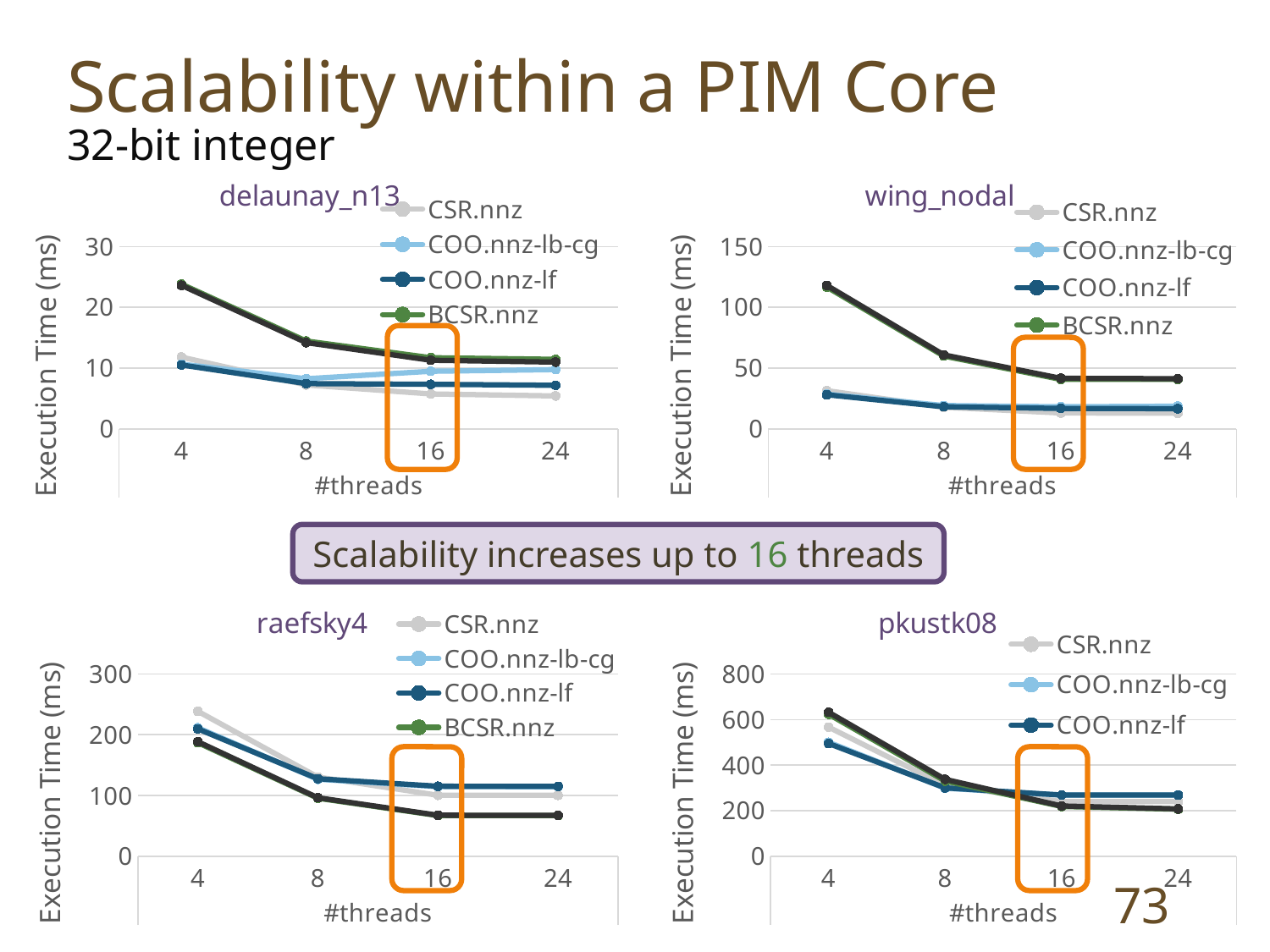
In the raefsky4 chart, is the value for CSR.nnz at 4 threads greater or less than 200? greater In the delaunay_n13 chart, is the value for CSR.nnz at 24 threads greater or less than 10? less How many #threads values are plotted on the x axis of the raefsky4 chart? 4 In the wing_nodal chart, does the execution time of BCSR.nnz rise or fall as #threads increases from 4 to 16? fall How many series does the legend of the pkustk08 chart list? 3 In the pkustk08 chart, is the value for COO.nnz-lf at 4 threads greater or less than 400? greater How many series does the legend of the wing_nodal chart list? 4 What is the y-axis label of the pkustk08 chart? Execution Time (ms) What kind of chart is the delaunay_n13 chart? line chart Which #threads value is highlighted by the orange box in each chart? 16